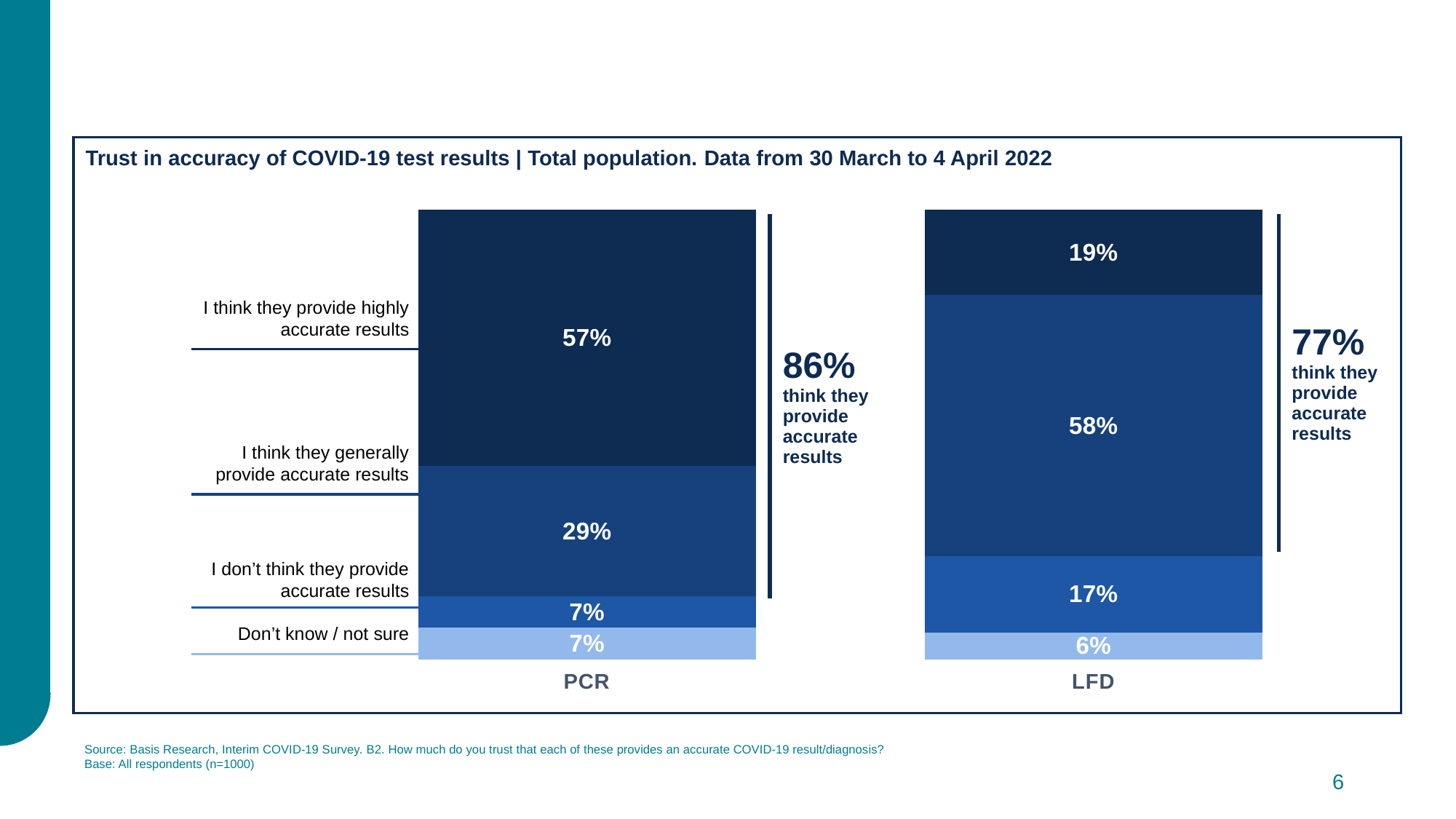
What is the difference between the share who think PCR tests provide highly accurate results and the share who think LFD tests provide highly accurate results? 38% What is the difference between the overall 'think they provide accurate results' figures for PCR and LFD? 9% What percentage of respondents answered 'Don't know / not sure' for PCR tests? 7% Which test has the larger share of respondents who think it provides highly accurate results, PCR or LFD? PCR What percentage of respondents think LFD tests generally provide accurate results? 58% What type of chart is shown on the slide? Stacked bar chart What percentage of respondents don't think LFD tests provide accurate results? 17% How many test types (bars) are shown in the chart? 2 Which response category is the largest segment in the LFD bar? I think they generally provide accurate results What percentage of respondents think PCR tests provide highly accurate results? 57% Which response category is the smallest segment in the LFD bar? Don't know / not sure What share of respondents think PCR tests provide accurate results overall, according to the summary figure? 86%